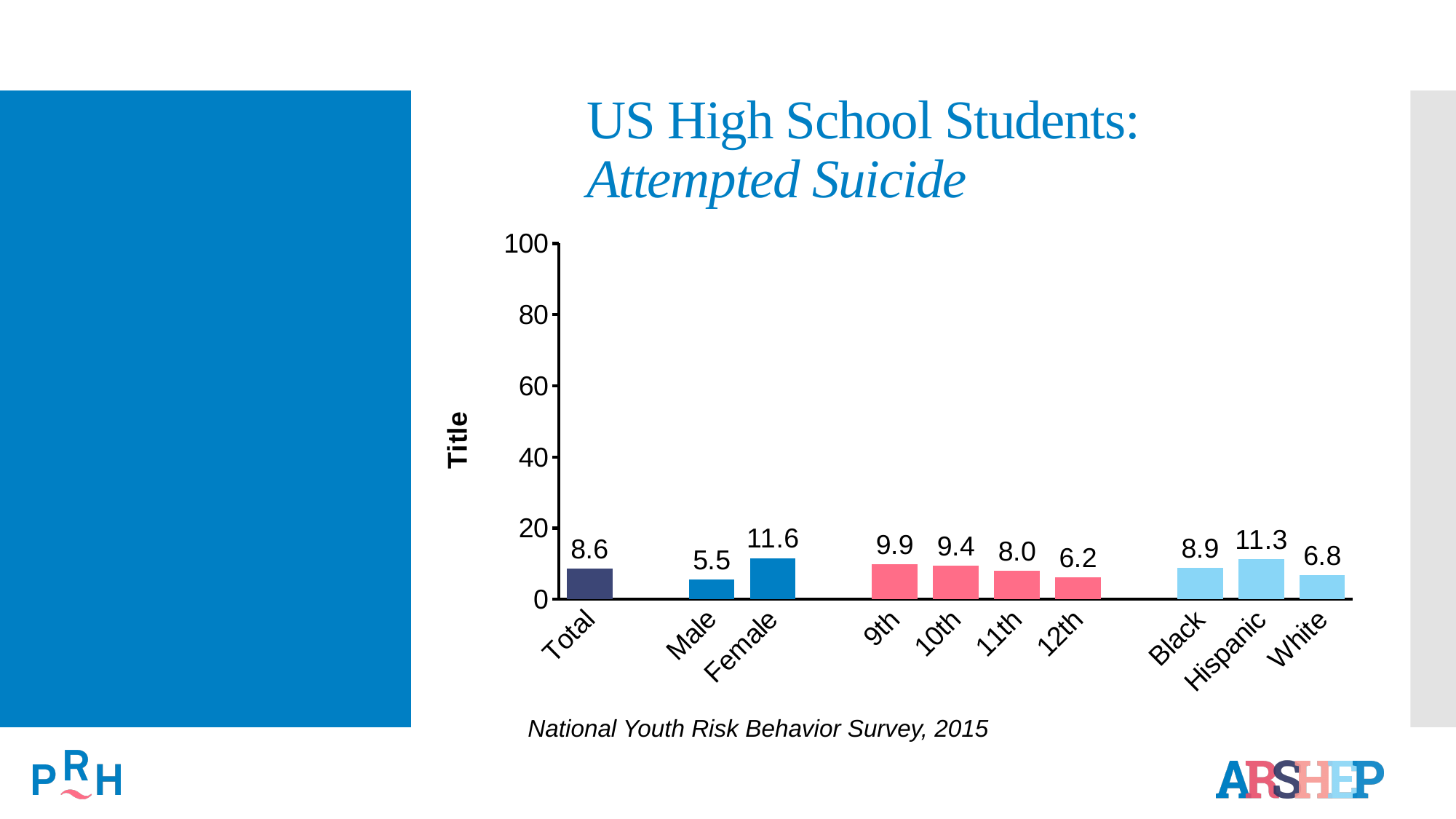
Which category has the highest value? Female What is the value for Hispanic students? 11.3 What is the value for Female? 11.6 Do the values rise or fall from 9th grade to 12th grade? fall How many bars are shown in the chart? 10 Is the value for Total greater or less than 20? less What is the value for 11th graders? 8.0 What is the source cited below the chart? National Youth Risk Behavior Survey, 2015 What kind of chart is shown? bar chart What is the difference between the Female and Male values? 6.1 Which category has the lowest value? Male Which is larger, the value for Black or the value for White? Black